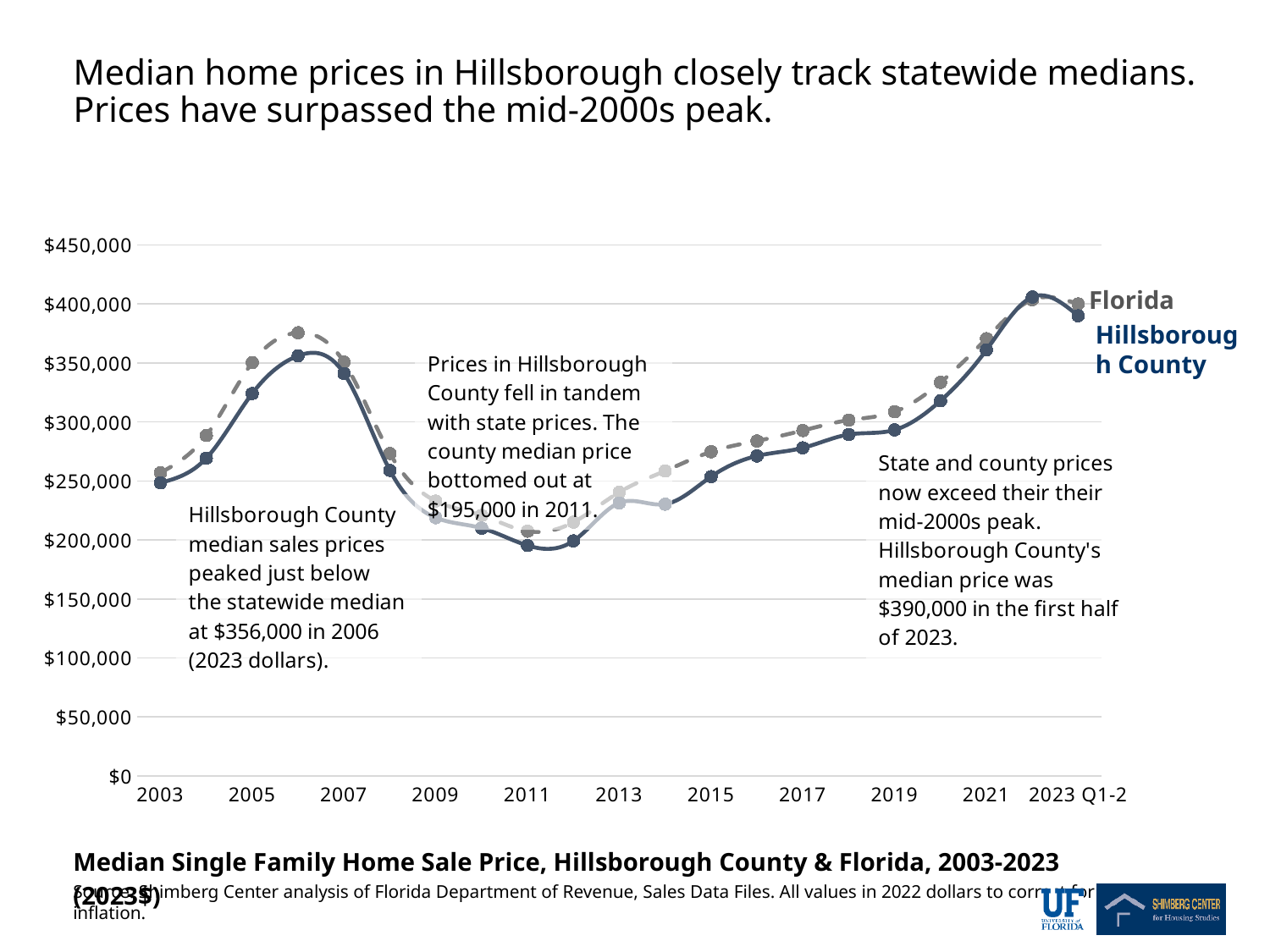
How did Hillsborough County median prices trend from 2011 to 2022? rose Is the Florida median price in 2006 greater or less than $350,000? greater Is the Florida median price in 2013 greater or less than $250,000? less What is the difference between Hillsborough County's 2006 peak median price and its 2011 low? $161,000 How much higher was Hillsborough County's median price in the first half of 2023 than at its 2006 peak? $34,000 Which two series are plotted on the chart? Florida and Hillsborough County What type of chart is shown on the slide? line chart What was the Hillsborough County median sales price at its 2006 peak? $356,000 What was the Hillsborough County median price when it bottomed out in 2011? $195,000 What was Hillsborough County's median price in the first half of 2023? $390,000 In 2006, which series had the higher median price, Florida or Hillsborough County? Florida How many series does the chart show? 2